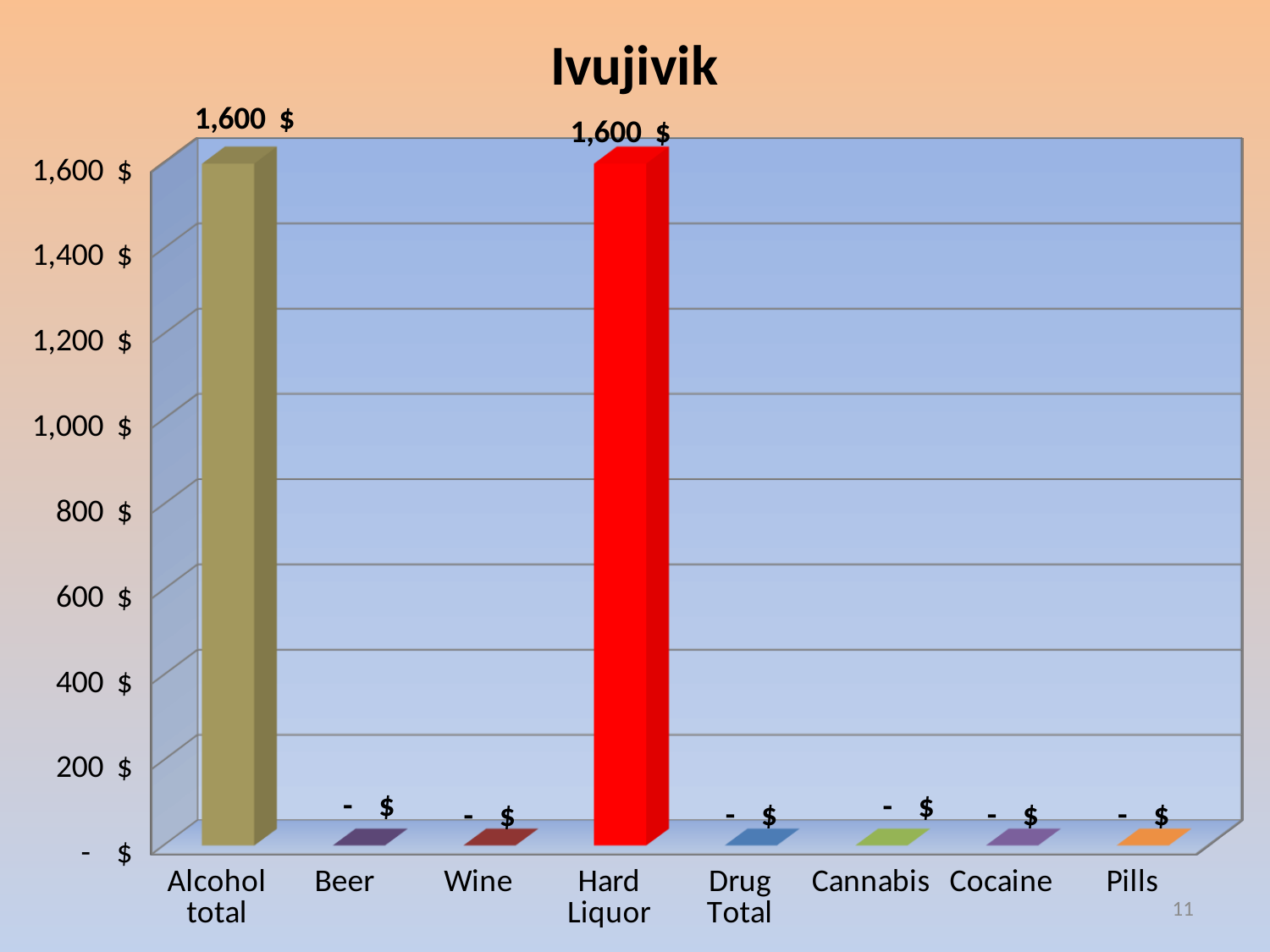
What kind of chart is this? bar chart Which is larger, the value for Alcohol total or the value for Wine? Alcohol total What colour is the Hard Liquor bar? red What is the value for Alcohol total? 1,600 $ How many categories are shown on the x axis? 8 What is the value shown for Beer? - $ What is the value for Hard Liquor? 1,600 $ What is the value shown for Drug Total? - $ Which two categories share the highest value? Alcohol total and Hard Liquor Is the value for Hard Liquor greater or less than 1,000 $? greater How many categories show a value of - $? 6 What is the title of the chart? Ivujivik